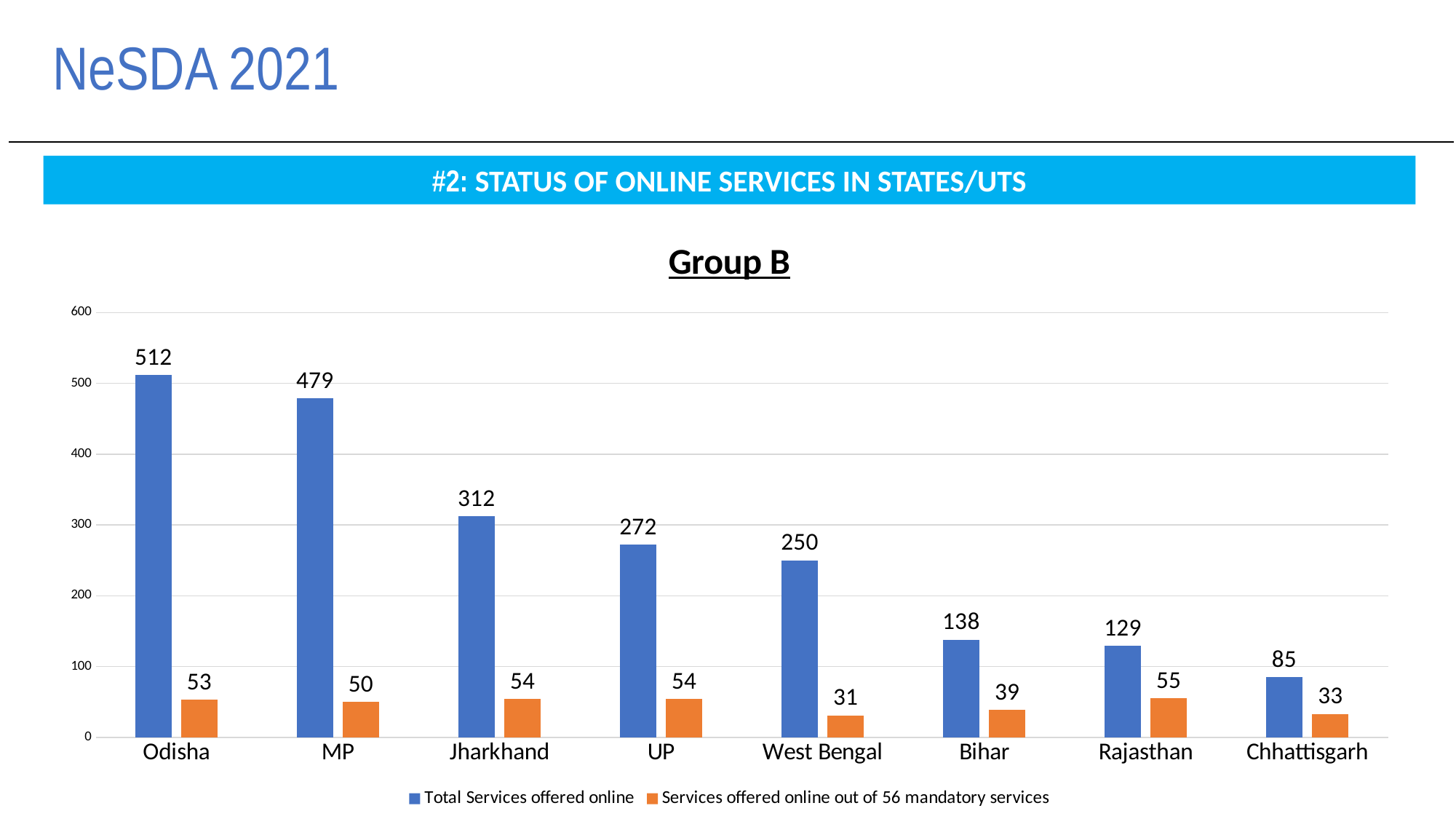
Which has more Total Services offered online, Bihar or Rajasthan? Bihar How many Services offered online out of 56 mandatory services does West Bengal have? 31 Which state has the highest value for Services offered online out of 56 mandatory services? Rajasthan How many series does the legend list? 2 Which state has the lowest Total Services offered online? Chhattisgarh How many states are shown on the x axis of the chart? 8 What is the title of the chart? Group B Which state has the highest Total Services offered online? Odisha Is the Total Services offered online for Jharkhand greater or less than 300? greater What is the value of Total Services offered online for Odisha? 512 What kind of chart is shown on the slide? Bar chart What is the difference in Total Services offered online between Odisha and MP? 33